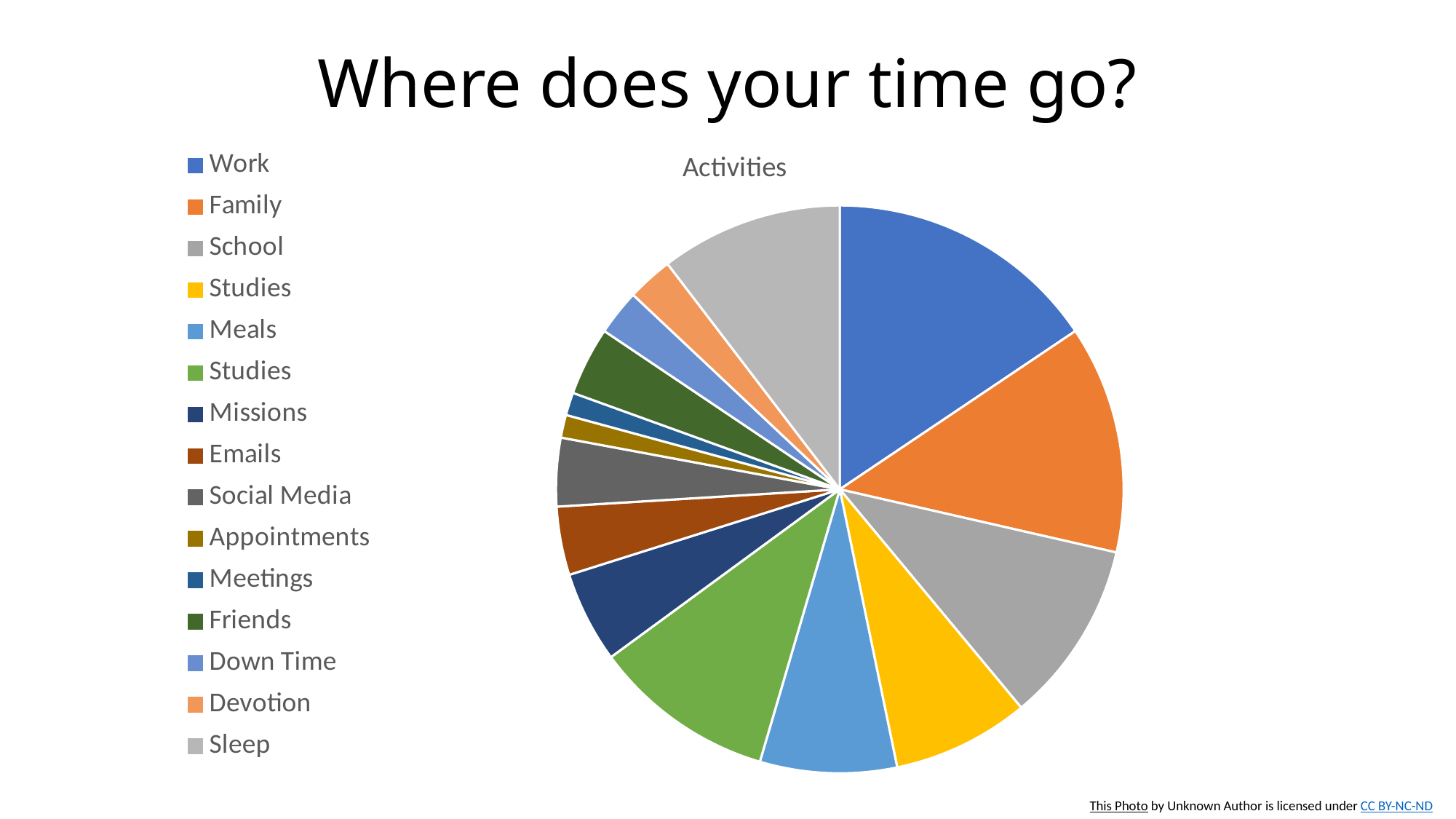
Which slice is larger, Work or Meals? Work Which category has the largest slice of the pie? Work Which slice is larger, School or Appointments? School Which category label appears twice in the legend? Studies What is the title of the chart? Activities What kind of chart is shown on the slide? Pie chart What colour is the Work slice in the pie chart? Blue Which slice is larger, Missions or Down Time? Missions How many categories does the legend of the pie chart list? 15